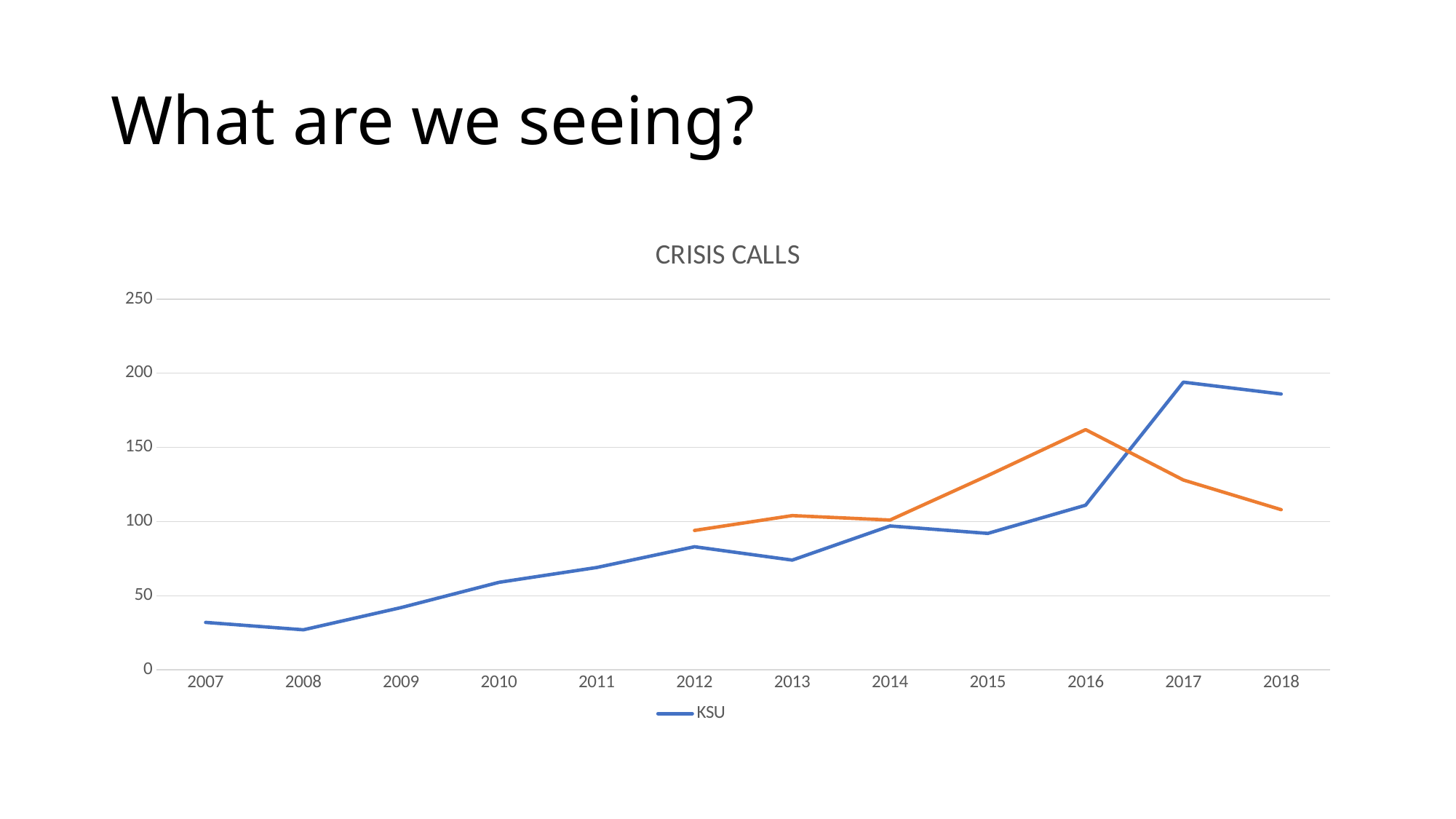
What kind of chart is shown on the slide? line chart How many series does the chart's legend list? 1 Is the KSU value for 2017 greater or less than 150? greater In which year does the KSU line reach its highest value? 2017 In which year does the KSU line reach its lowest value? 2008 What is the title of the chart? CRISIS CALLS Does the KSU line generally rise or fall from 2007 to 2018? rise In which year does the orange line reach its highest value? 2016 How many years are shown along the x axis of the chart? 12 Which year has the larger KSU value, 2016 or 2018? 2018 Is the KSU value for 2012 greater or less than 100? less Is the KSU value for 2007 greater or less than 50? less